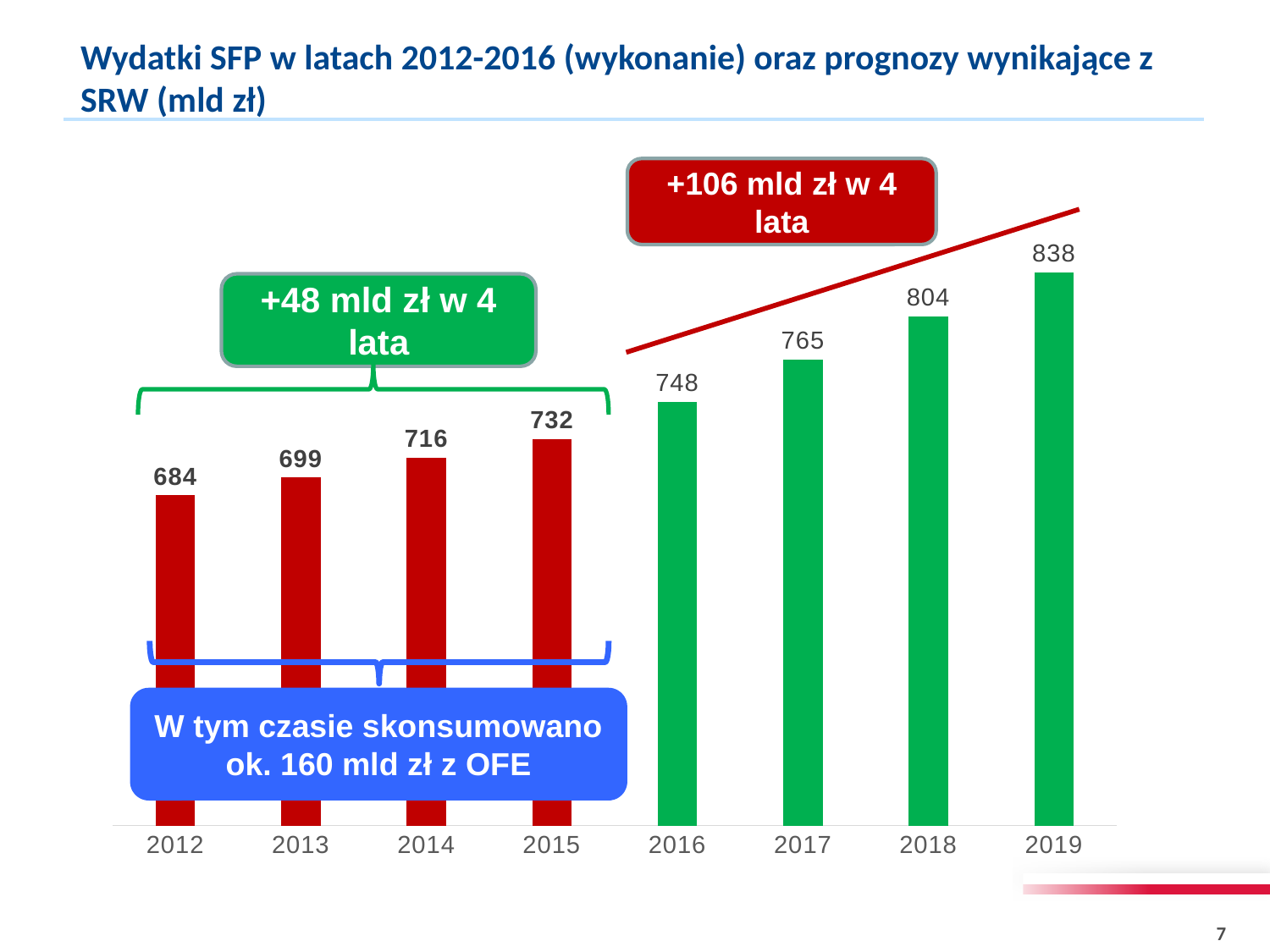
What is the difference between the values for 2019 and 2016? 90 Which year has the lowest value? 2012 Which is larger, the value for 2015 or the value for 2016? 2016 What is the difference between the values for 2015 and 2012? 48 What colour are the bars for 2016 to 2019? green What is the value for 2019? 838 What is the value for 2012? 684 What is the value for 2016? 748 What kind of chart is this? bar chart How many years are shown on the x axis? 8 Do the values rise or fall from 2012 to 2019? rise Which year has the highest value? 2019